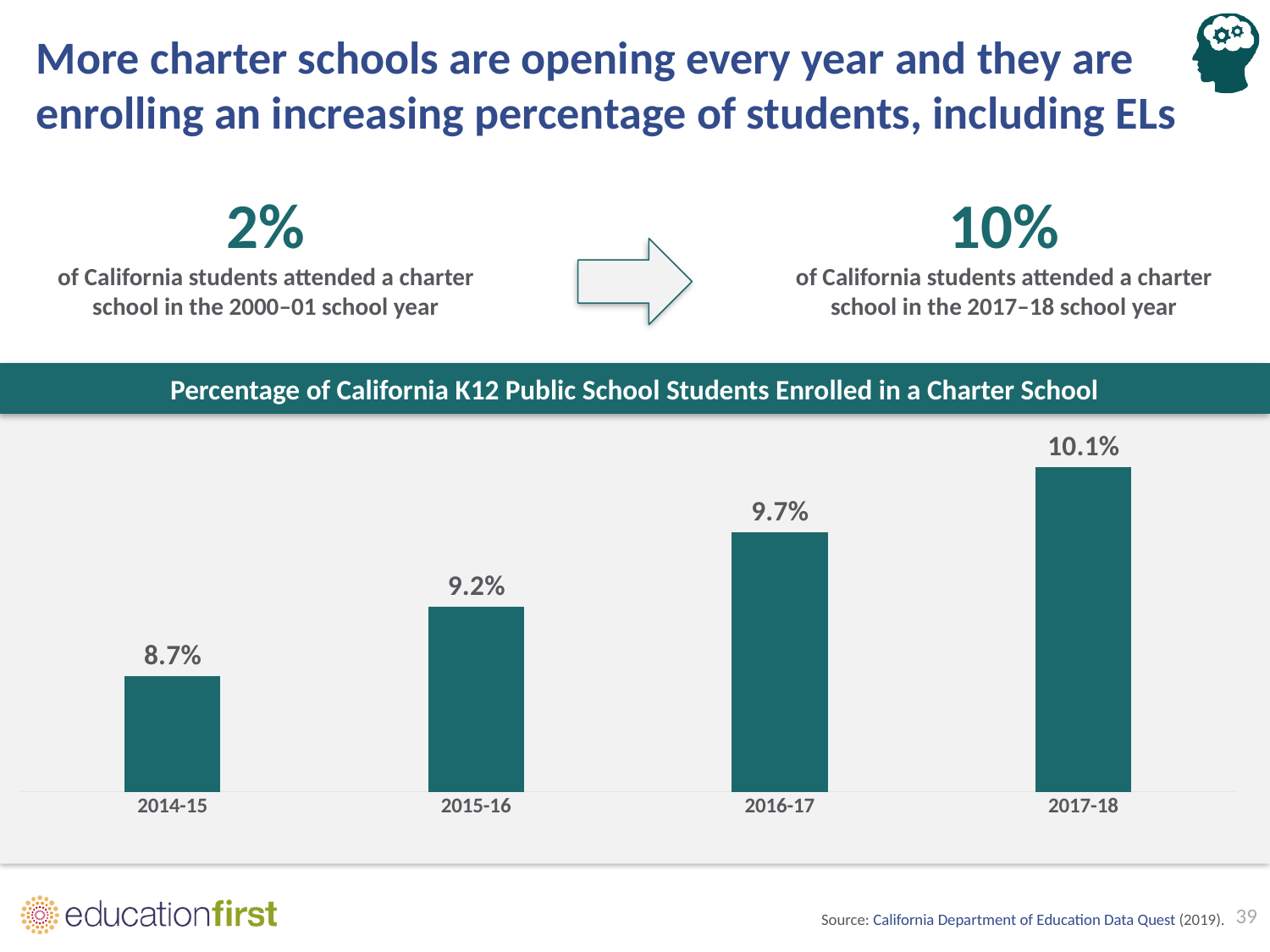
Do the values rise or fall from 2014-15 to 2017-18? Rise What percentage of California K12 public school students were enrolled in a charter school in 2014-15? 8.7% Which school year has the highest percentage of students enrolled in a charter school? 2017-18 What is the value shown for 2015-16? 9.2% Which school year has the lowest percentage of students enrolled in a charter school? 2014-15 What is the value shown for 2016-17? 9.7% What is the value shown for 2017-18? 10.1% What is the difference in percentage points between 2016-17 and 2015-16? 0.5 How many school years are shown in the chart? 4 What kind of chart is shown on the slide? Bar chart Which is larger, the value for 2015-16 or the value for 2016-17? 2016-17 What is the difference in percentage points between 2017-18 and 2014-15? 1.4